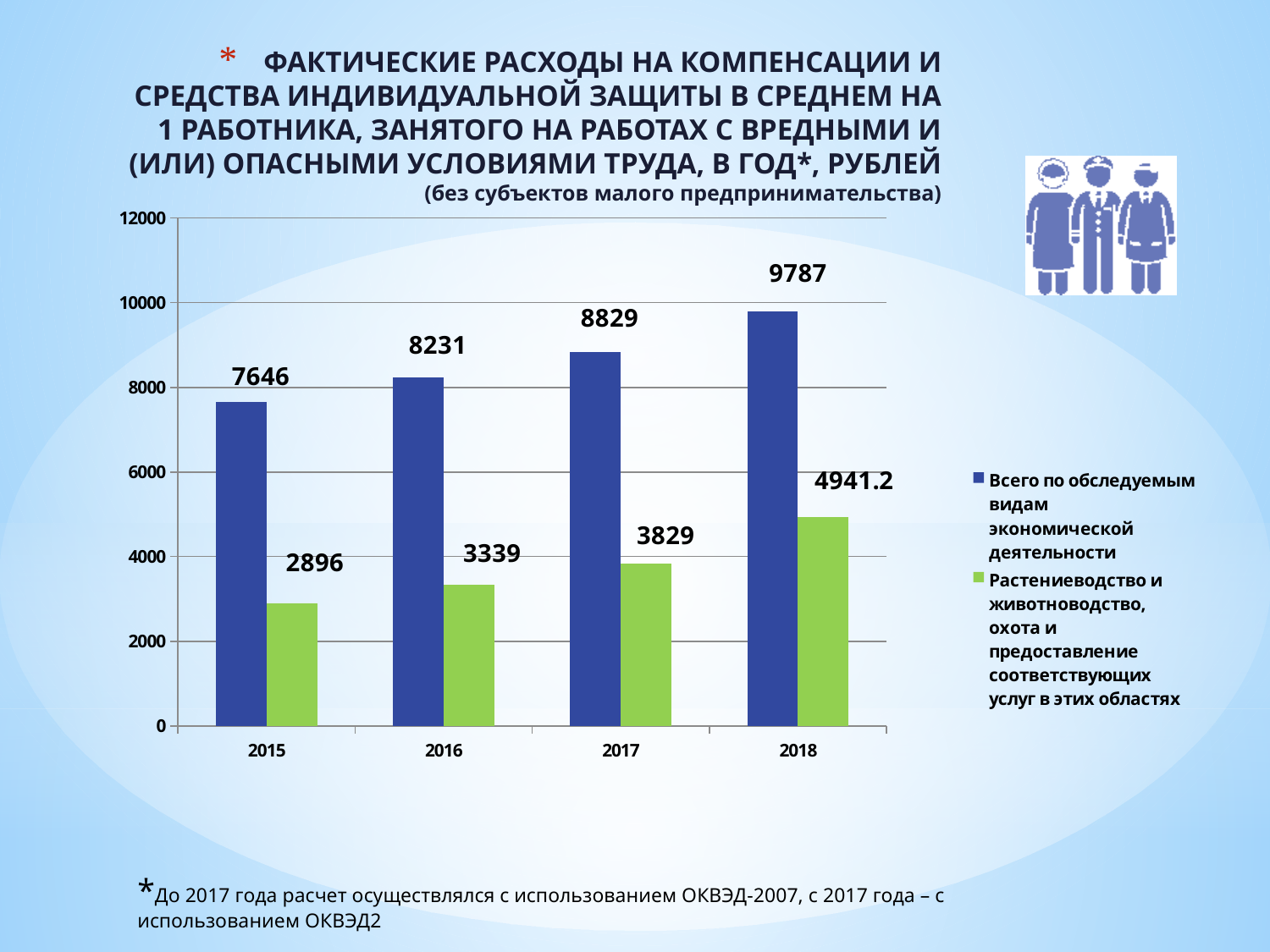
What is the difference between the 2016 and 2015 values for 'Всего по обследуемым видам экономической деятельности'? 585 Do the values for 'Растениеводство и животноводство, охота и предоставление соответствующих услуг в этих областях' rise or fall from 2015 to 2018? Rise In which year is the value for 'Растениеводство и животноводство, охота и предоставление соответствующих услуг в этих областях' the lowest? 2015 How many series does the legend list? 2 Which is larger in 2016: the value for 'Всего по обследуемым видам экономической деятельности' or for 'Растениеводство и животноводство, охота и предоставление соответствующих услуг в этих областях'? Всего по обследуемым видам экономической деятельности In which year is the value for 'Всего по обследуемым видам экономической деятельности' the highest? 2018 What is the difference between the two series' values in 2017? 5000 How many years are shown on the x axis? 4 What is the value for 'Растениеводство и животноводство, охота и предоставление соответствующих услуг в этих областях' in 2018? 4941.2 What is the value for 'Растениеводство и животноводство, охота и предоставление соответствующих услуг в этих областях' in 2015? 2896 What is the value for 'Всего по обследуемым видам экономической деятельности' in 2018? 9787 What kind of chart is shown on the slide? Bar chart